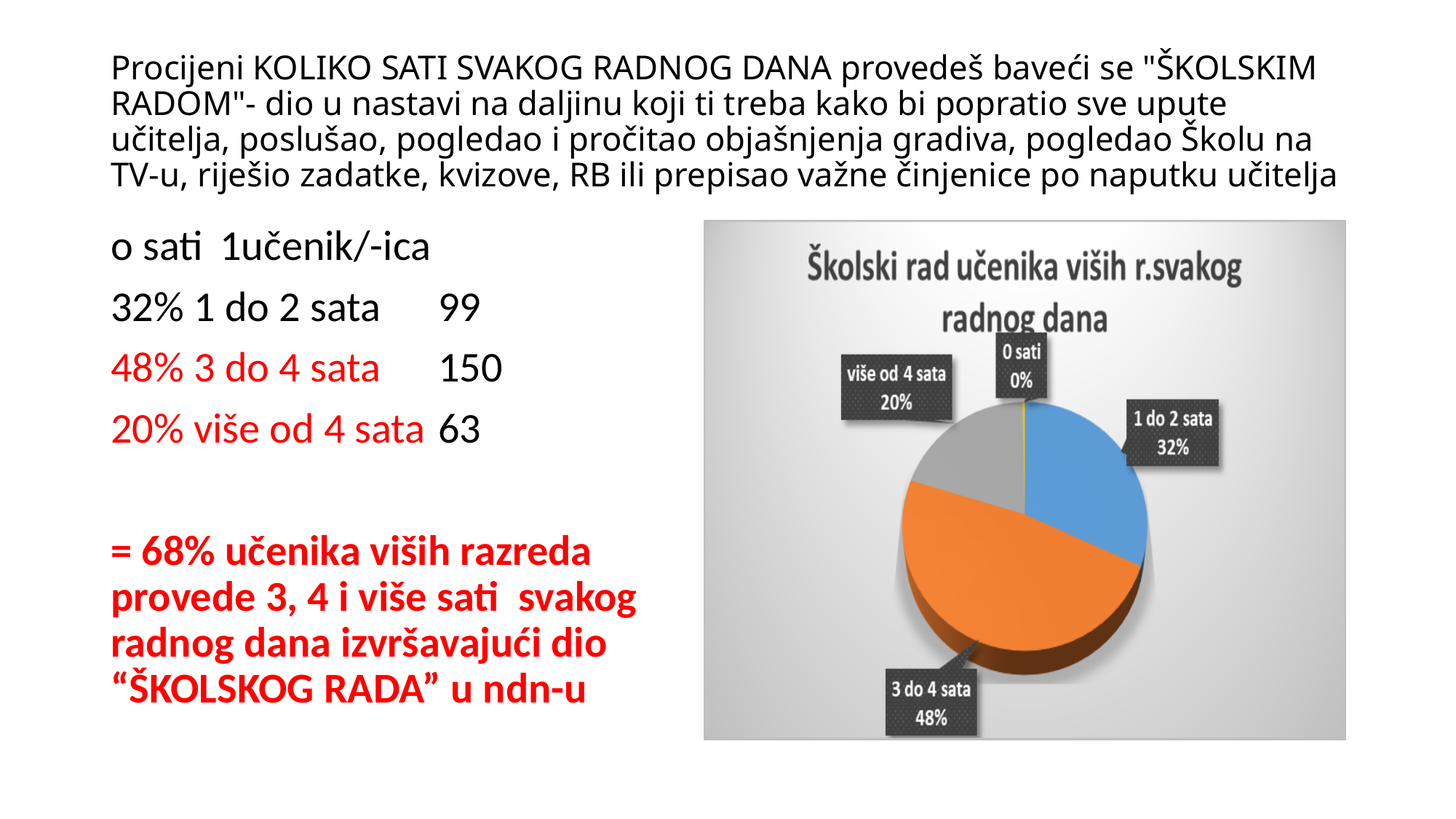
Which category has the largest share of the pie? 3 do 4 sata Which category has the smallest share of the pie? 0 sati Which slice is larger, "1 do 2 sata" or "više od 4 sata"? 1 do 2 sata What percentage is shown for the "3 do 4 sata" slice? 48% What percentage is shown for the "0 sati" slice? 0% What percentage is shown for the "1 do 2 sata" slice? 32% What colour is the "3 do 4 sata" slice? orange What percentage is shown for the "više od 4 sata" slice? 20% What is the title of the pie chart? Školski rad učenika viših r.svakog radnog dana How many categories are labelled on the pie chart? 4 What kind of chart is shown on the slide? pie chart What is the difference in percentage points between the "3 do 4 sata" and "1 do 2 sata" slices? 16